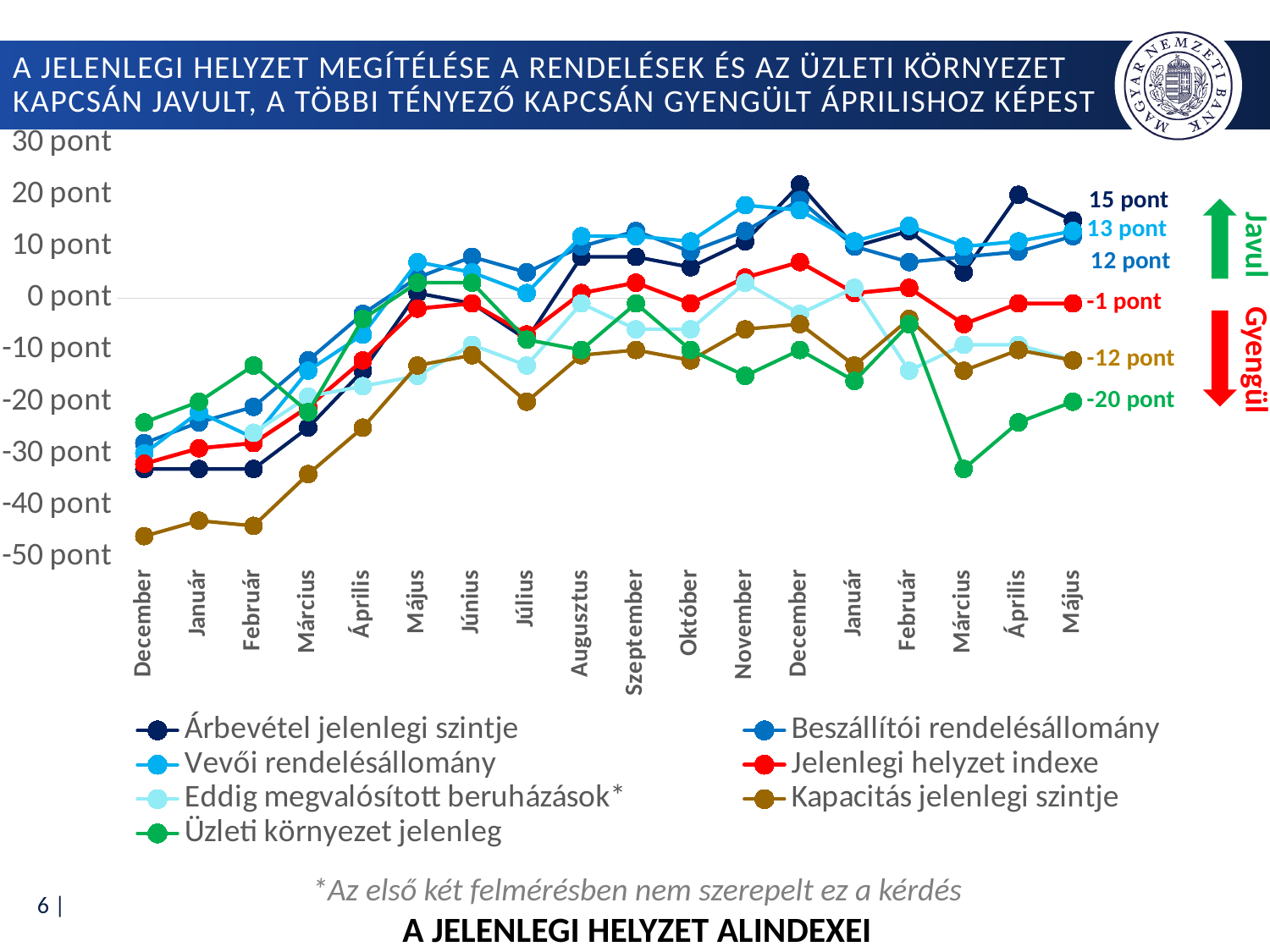
Which series has the lowest value at the first December? Kapacitás jelenlegi szintje Is the value of Kapacitás jelenlegi szintje at the first December greater or less than -40 pont? less What is the value of Üzleti környezet jelenleg at the last Május? -20 pont What is the value of Árbevétel jelenlegi szintje at the last Május? 15 pont What kind of chart is shown on the slide? line chart How many series does the legend list? 7 At the last Május, which is higher: Árbevétel jelenlegi szintje or Beszállítói rendelésállomány? Árbevétel jelenlegi szintje At the last Május, what is the difference between Árbevétel jelenlegi szintje and Üzleti környezet jelenleg? 35 pont What is the value of Beszállítói rendelésállomány at the last Május? 12 pont What is the value of Jelenlegi helyzet indexe at the last Május? -1 pont What is the value of Vevői rendelésállomány at the last Május? 13 pont How many months are shown along the x axis? 18